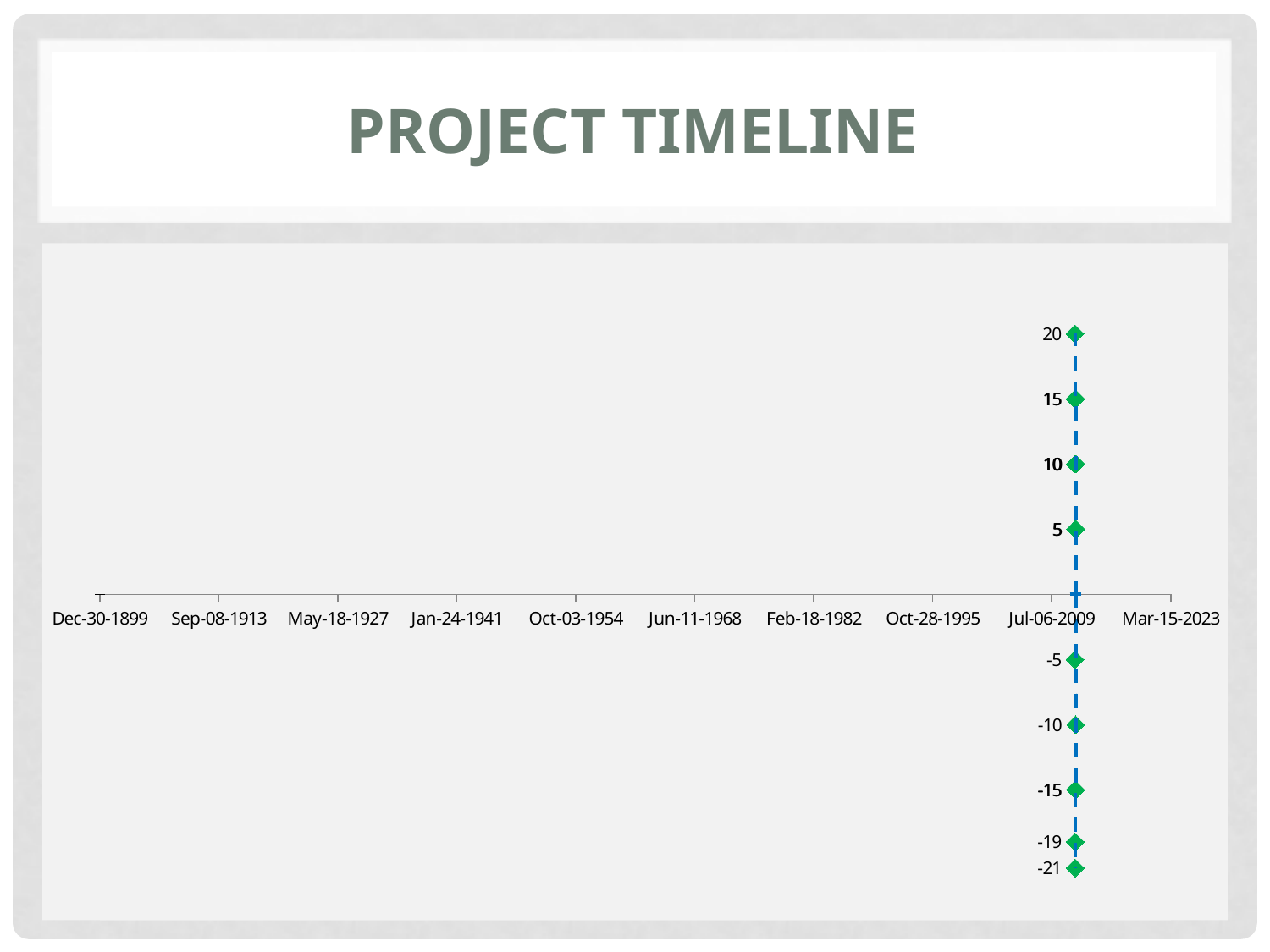
What is the first date label on the x axis? Dec-30-1899 What is the highest data label shown on the chart? 20 What is the title of the chart? Project Timeline What is the difference between the highest data label (20) and the lowest data label (-21)? 41 What is the difference between the data labels -19 and -21? 2 Which is larger, the data label 15 or the data label -15? 15 What is the lowest data label shown on the chart? -21 Near which x-axis date label are all the data points clustered? Jul-06-2009 What is the last date label on the x axis? Mar-15-2023